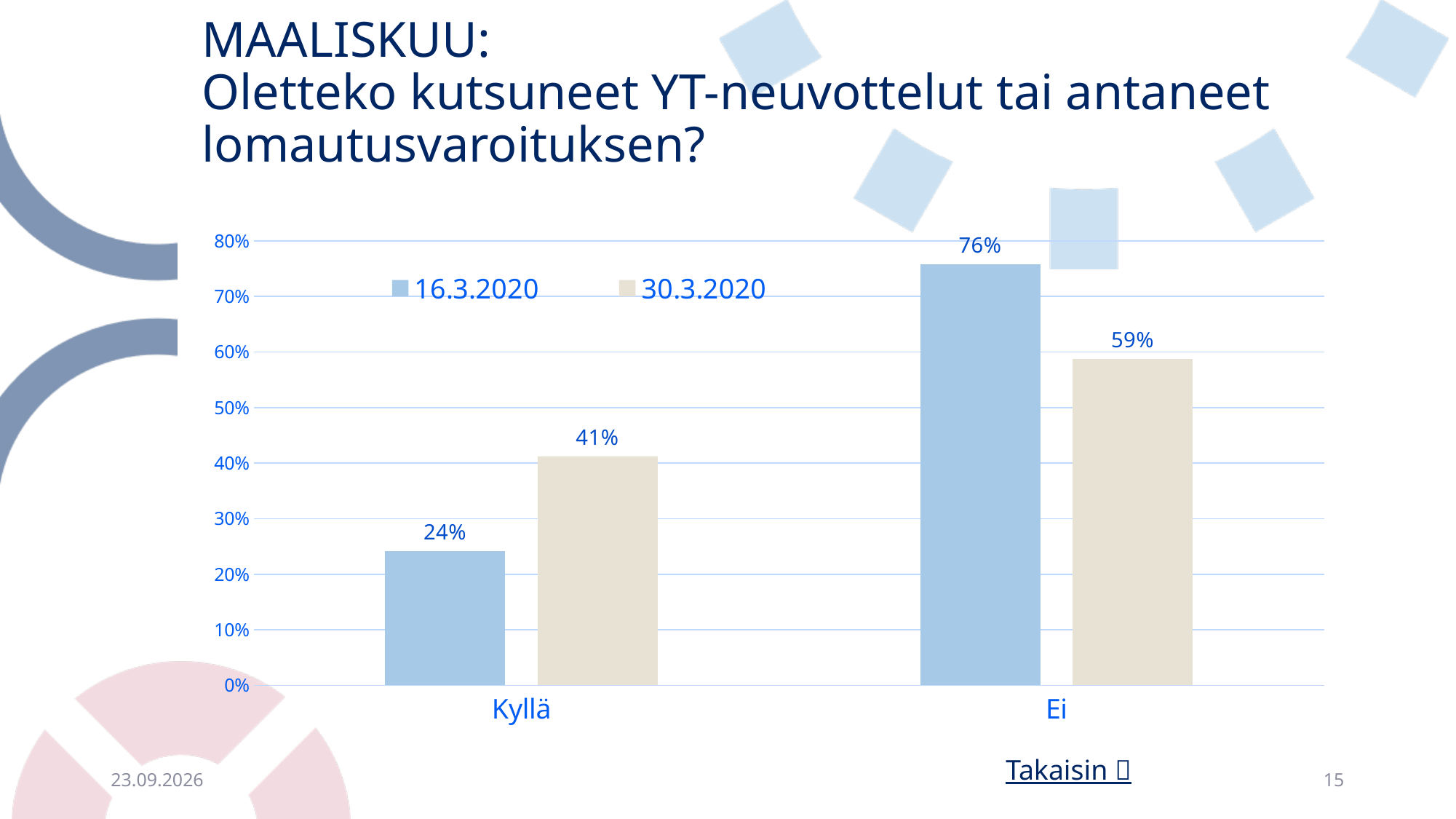
What is the difference between the 30.3.2020 and 16.3.2020 values for Kyllä? 17% How many categories are shown on the x axis? 2 Which is larger for Kyllä: the 16.3.2020 value or the 30.3.2020 value? 30.3.2020 How many series does the legend list? 2 What is the value for Ei in the 16.3.2020 series? 76% What is the value for Kyllä in the 16.3.2020 series? 24% What is the value for Ei in the 30.3.2020 series? 59% Which category has the lowest value in the 30.3.2020 series? Kyllä What is the difference between the 16.3.2020 and 30.3.2020 values for Ei? 17% What is the value for Kyllä in the 30.3.2020 series? 41% Which category has the highest value in the 16.3.2020 series? Ei What kind of chart is shown on the slide? Bar chart